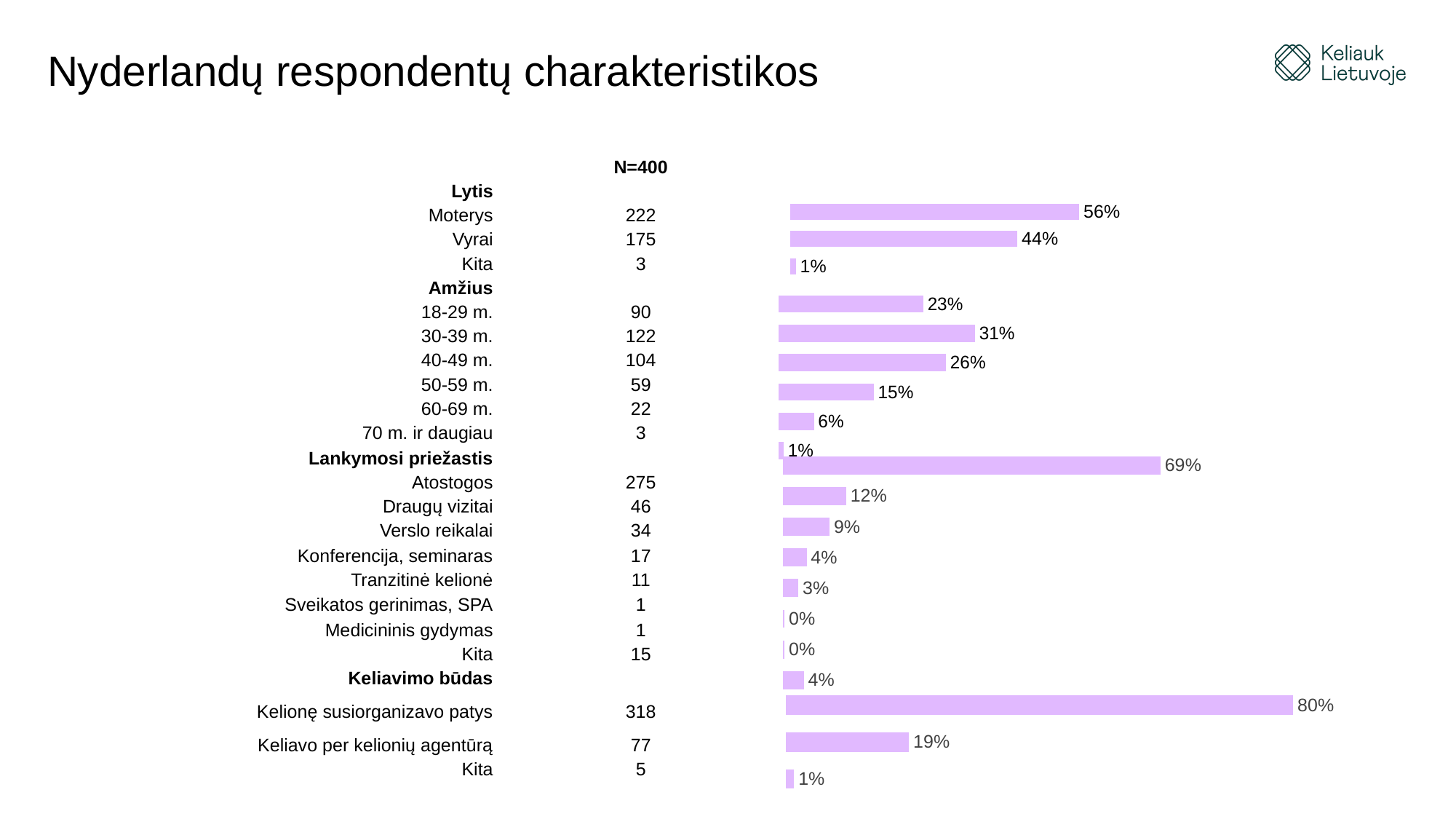
How many categories are listed under Lankymosi priežastis? 8 What percentage of respondents gave Atostogos as their reason for visiting? 69% What percentage of respondents chose Keliavo per kelionių agentūrą? 19% What type of chart is used to show the percentages? Bar chart Which is larger, the share for Draugų vizitai or the share for Verslo reikalai? Draugų vizitai What is the difference in percentage points between Kelionę susiorganizavo patys and Keliavo per kelionių agentūrą? 61 Which age group has the lowest share of respondents? 70 m. ir daugiau What percentage of respondents are in the 30-39 m. age group? 31% How many respondents in total are represented (N)? 400 Which age group has the highest share of respondents? 30-39 m. What is the difference in percentage points between Moterys and Vyrai? 12 What percentage of respondents are Moterys? 56%